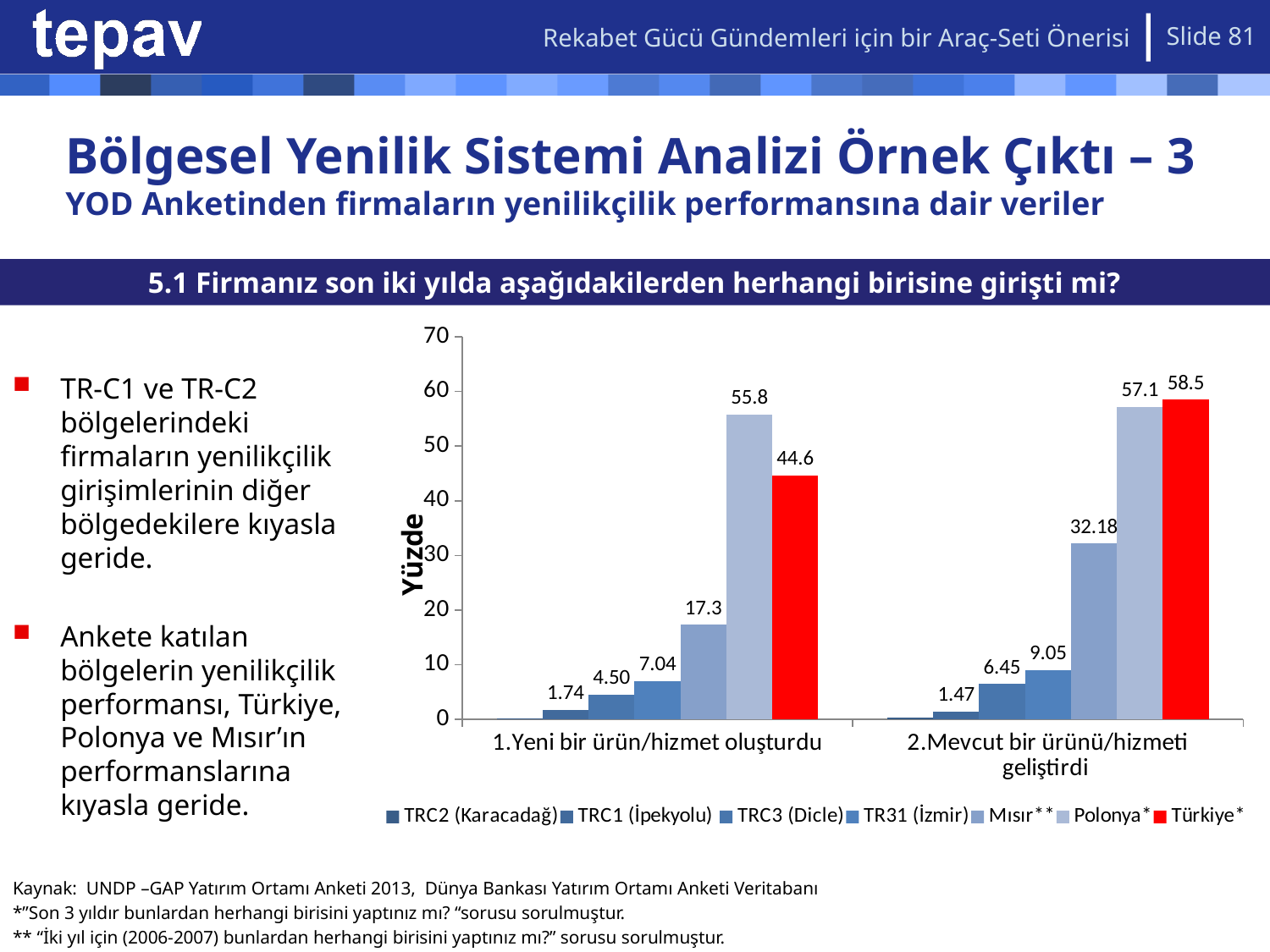
What is the value for TRC1 (İpekyolu) in the category "1.Yeni bir ürün/hizmet oluşturdu"? 1.74 Which series has the highest value in the category "2.Mevcut bir ürünü/hizmeti geliştirdi"? Türkiye* How many series does the chart legend list? 7 Is the value for TRC2 (Karacadağ) in the category "2.Mevcut bir ürünü/hizmeti geliştirdi" greater or less than 10? less How many categories are shown on the x axis of the chart? 2 Is the value for TR31 (İzmir) larger in "1.Yeni bir ürün/hizmet oluşturdu" or in "2.Mevcut bir ürünü/hizmeti geliştirdi"? 2.Mevcut bir ürünü/hizmeti geliştirdi What kind of chart is shown on the slide? bar chart What is the value for Mısır** in the category "2.Mevcut bir ürünü/hizmeti geliştirdi"? 32.18 Which series has the highest value in the category "1.Yeni bir ürün/hizmet oluşturdu"? Polonya* What is the value for Polonya* in the category "2.Mevcut bir ürünü/hizmeti geliştirdi"? 57.1 What is the difference between the Polonya* and Türkiye* values in the category "1.Yeni bir ürün/hizmet oluşturdu"? 11.2 What is the value for Türkiye* in the category "1.Yeni bir ürün/hizmet oluşturdu"? 44.6